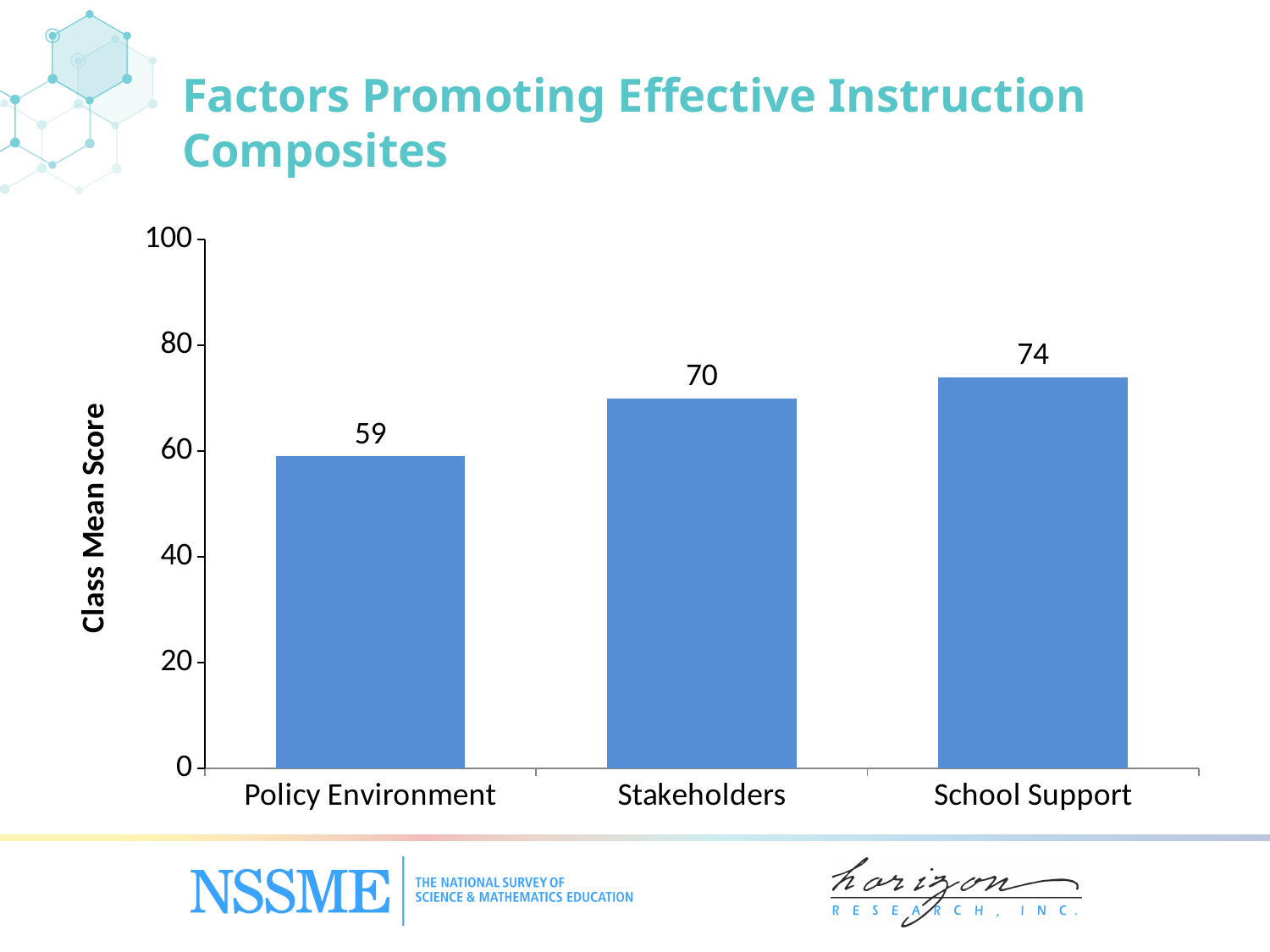
Which category has the highest class mean score? School Support What is the difference between the class mean scores for School Support and Policy Environment? 15 Which has a higher class mean score, Stakeholders or Policy Environment? Stakeholders What is the class mean score for School Support? 74 How many categories are shown on the x axis? 3 What kind of chart is shown on the slide? bar chart What is the label of the vertical axis? Class Mean Score What is the difference between the class mean scores for Stakeholders and Policy Environment? 11 What is the class mean score for Policy Environment? 59 What is the class mean score for Stakeholders? 70 Is the value for Policy Environment greater or less than 60? less Which category has the lowest class mean score? Policy Environment